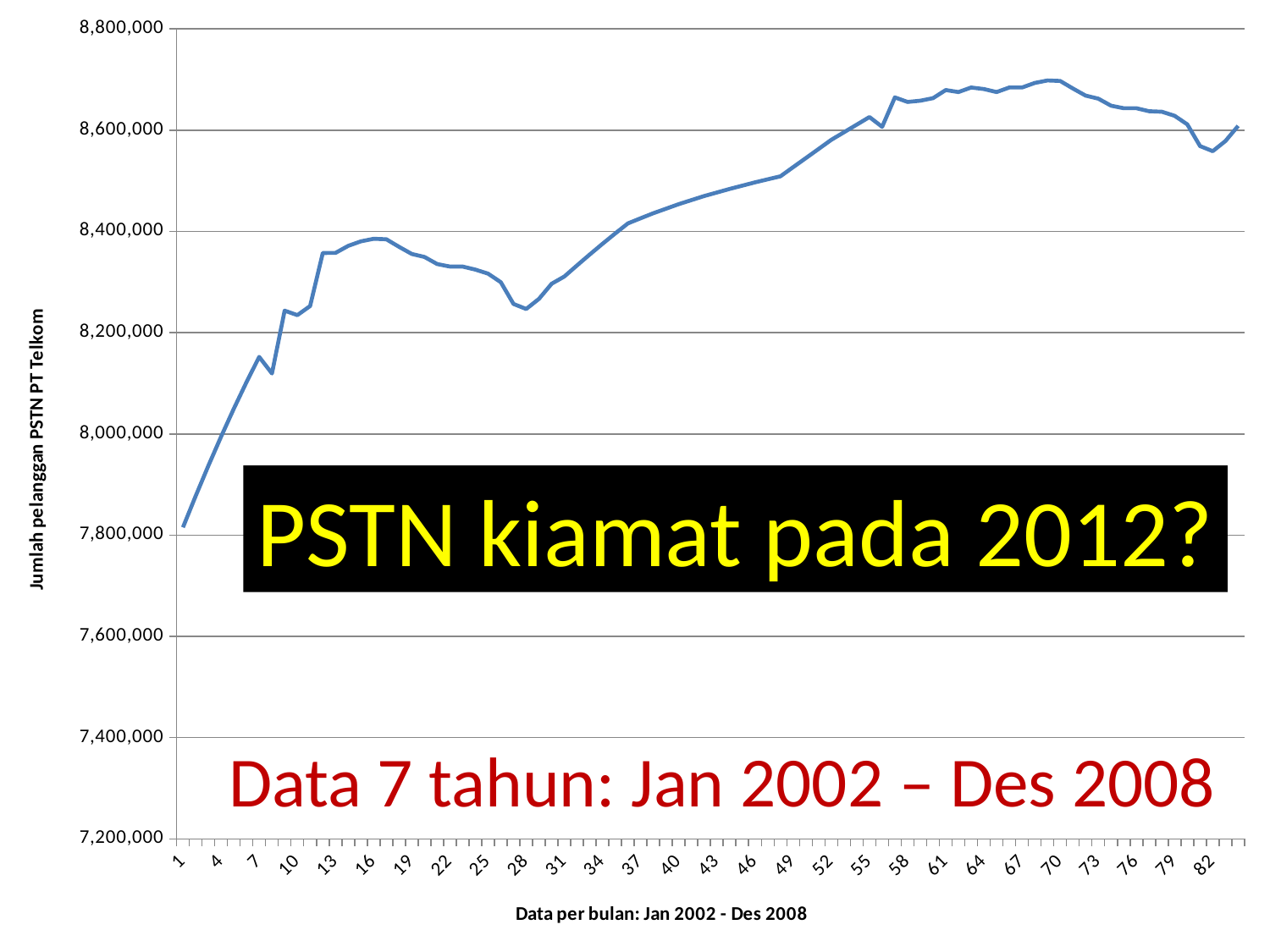
Is the value at month 1 greater or less than 8,000,000? less Do the values rise or fall between month 1 and month 13? rise What kind of chart is shown on the slide? line chart Which month has the lowest value on the chart? 1 Is the value at month 82 greater or less than 8,600,000? less Is the value at month 70 greater or less than 8,600,000? greater Do the values rise or fall between month 70 and month 82? fall Which is larger, the value at month 16 or the value at month 28? month 16 What is the title of the vertical axis? Jumlah pelanggan PSTN PT Telkom What is the title of the horizontal axis? Data per bulan: Jan 2002 - Des 2008